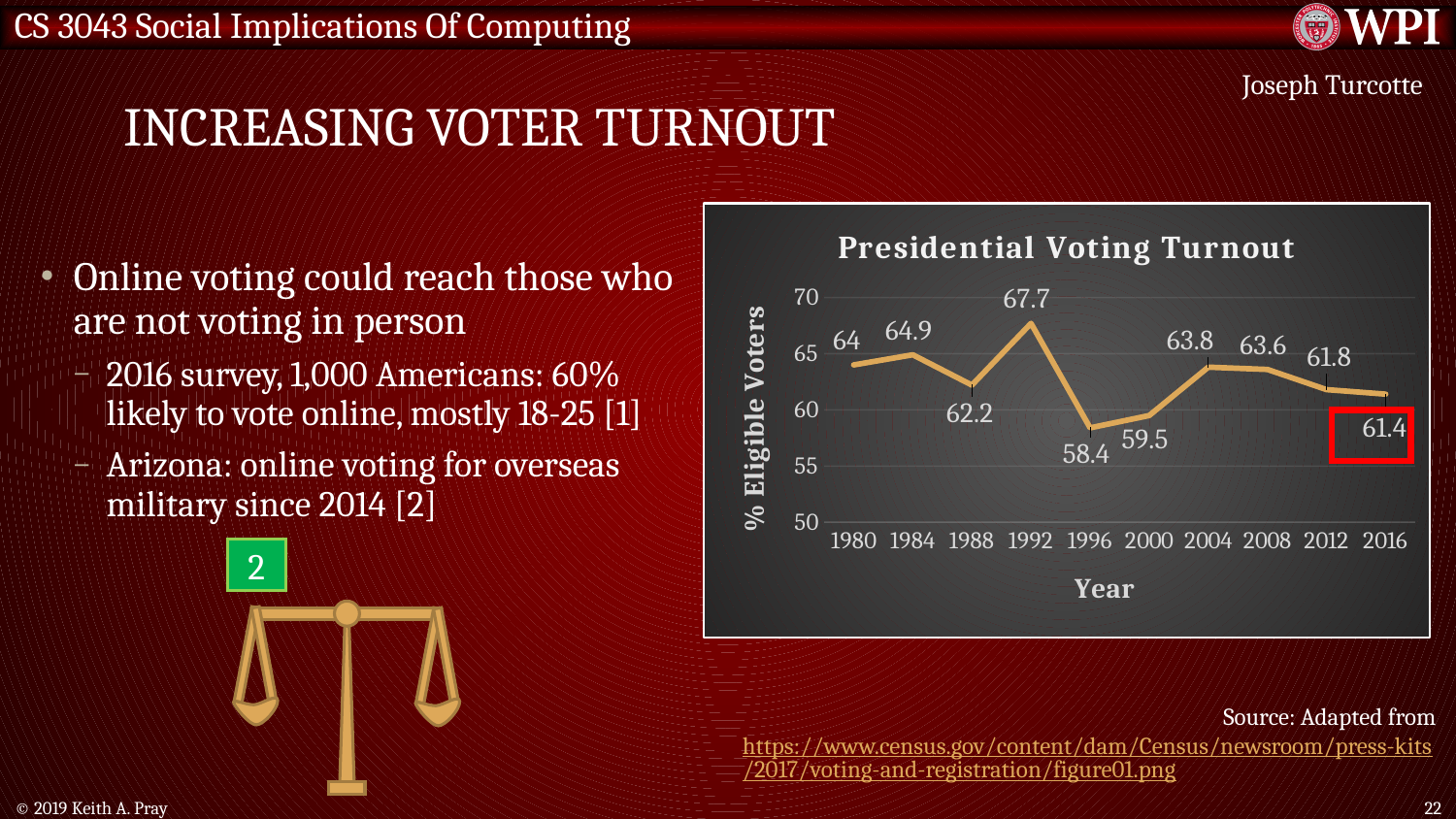
Which year has a higher turnout, 1984 or 2004? 1984 How many years are plotted on the chart? 10 What is the voter turnout value for 1992? 67.7 What type of chart is shown on the slide? line chart What is the difference between the turnout in 1992 and the turnout in 1996? 9.3 What is the voter turnout value for 1996? 58.4 What is the title of the chart? Presidential Voting Turnout Is the turnout value for 2000 greater or less than 60? less What is the voter turnout value for 2016? 61.4 Which year has the highest voter turnout? 1992 Which year has the lowest voter turnout? 1996 What is the label of the y axis? % Eligible Voters